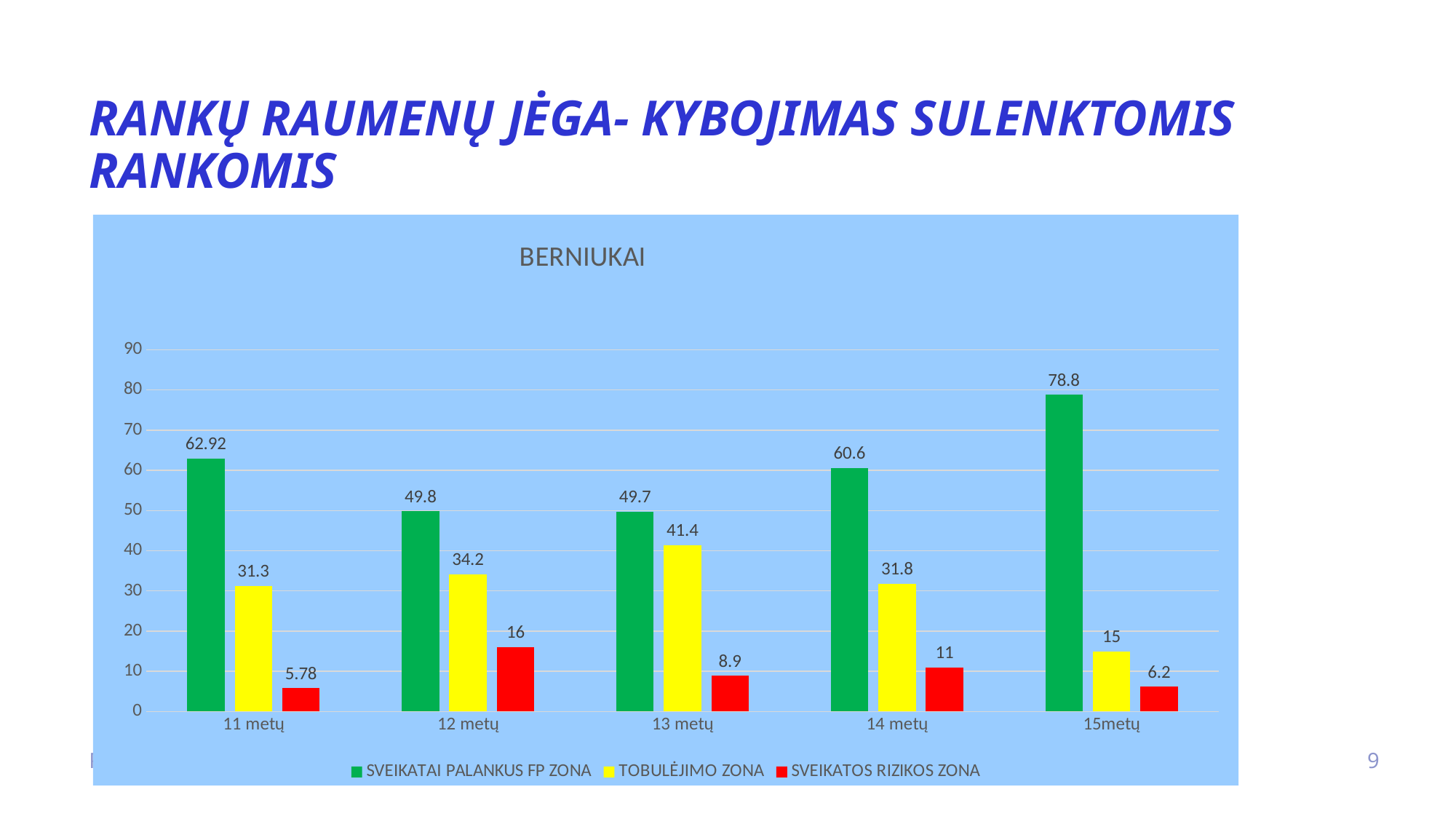
What is the difference between the SVEIKATAI PALANKUS FP ZONA values for 15metų and 14 metų? 18.2 What is the value of SVEIKATAI PALANKUS FP ZONA for 11 metų? 62.92 How many age groups are shown on the x axis? 5 What is the value of SVEIKATOS RIZIKOS ZONA for 12 metų? 16 Is the value of SVEIKATAI PALANKUS FP ZONA for 13 metų greater or less than 60? less What is the title of the chart? BERNIUKAI Which is larger: TOBULĖJIMO ZONA for 12 metų or for 14 metų? 12 metų How many series does the legend list? 3 What is the value of TOBULĖJIMO ZONA for 13 metų? 41.4 What kind of chart is shown? bar chart Which age group has the highest value for SVEIKATAI PALANKUS FP ZONA? 15metų Which age group has the lowest value for SVEIKATOS RIZIKOS ZONA? 11 metų